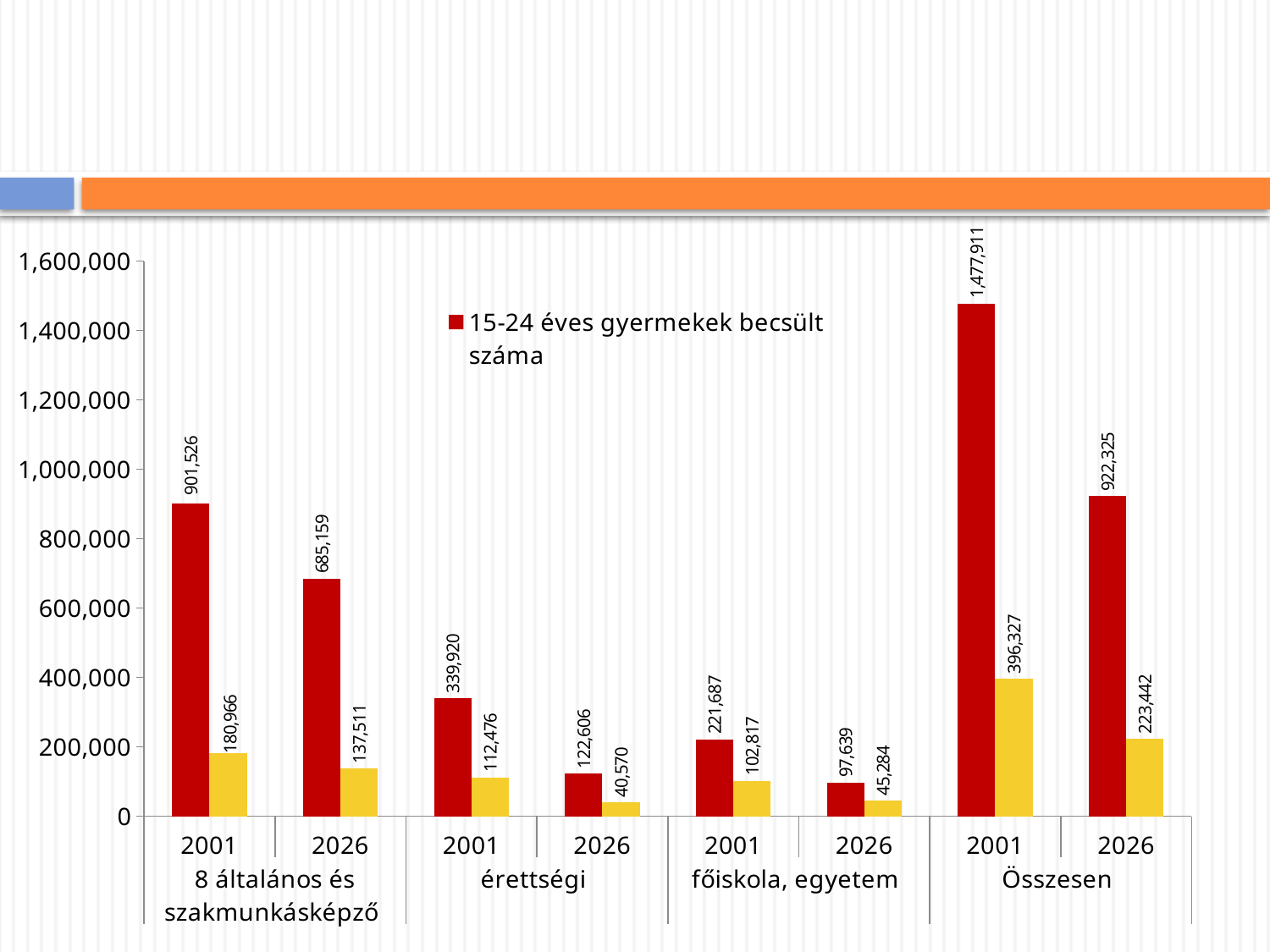
What is the difference between the red bar values for 2001 and 2026 in the "Összesen" group? 555,586 How many year bars (2001/2026 pairs) are shown across all groups on the x axis? 8 What is the value of the red bar (15-24 éves gyermekek becsült száma) for 2001 in the "8 általános és szakmunkásképző" group? 901,526 What is the value of the red bar for 2026 in the "Összesen" group? 922,325 What is the value of the yellow bar for 2026 in the "főiskola, egyetem" group? 45,284 What type of chart is shown on the slide? Bar chart Which is larger: the red bar for 2001 in "érettségi" or the red bar for 2001 in "főiskola, egyetem"? érettségi 2001 Is the red bar for 2026 in the "8 általános és szakmunkásképző" group greater or less than 600,000? greater How many series does the legend list? 1 What is the value of the yellow bar for 2001 in the "érettségi" group? 112,476 Which yellow bar has the lowest value on the chart? érettségi 2026, 40,570 Which bar has the highest value on the chart? Összesen 2001 (red bar), 1,477,911